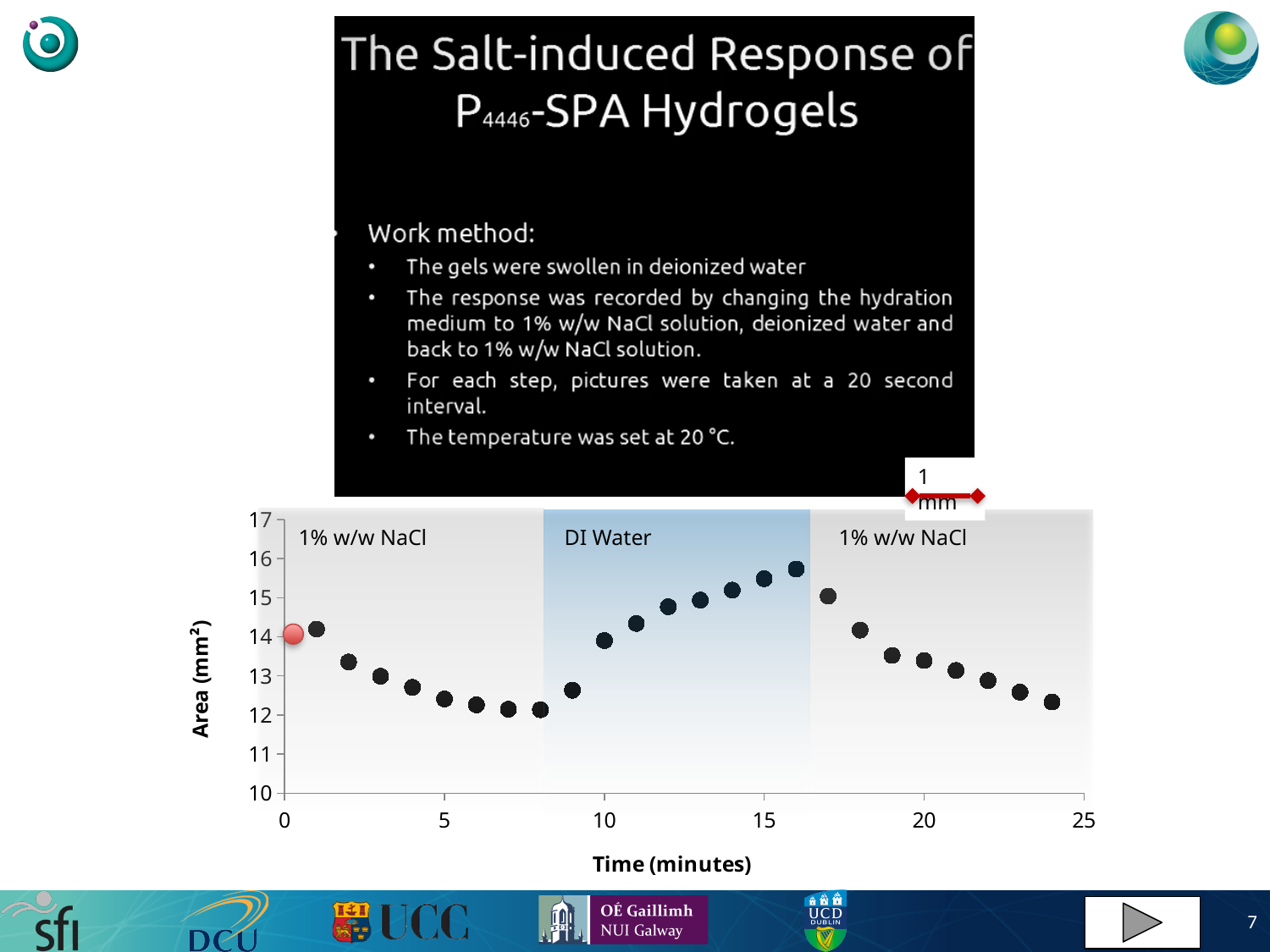
Is the area value at 16 minutes greater or less than 15? greater Is the area value at 24 minutes greater or less than 13? less What is the title of the x axis of the chart? Time (minutes) Which has the larger area value: the point at 1 minute or the point at 24 minutes? 1 minute Do the area values rise or fall over time within the DI Water region? rise At which time (in minutes) is the plotted area highest? 16 Is the area value at 7 minutes greater or less than 13? less Do the area values rise or fall over time within the first 1% w/w NaCl region? fall How many data points are plotted on the chart? 24 What kind of chart is shown on the slide? scatter chart What is the title of the y axis of the chart? Area (mm²)